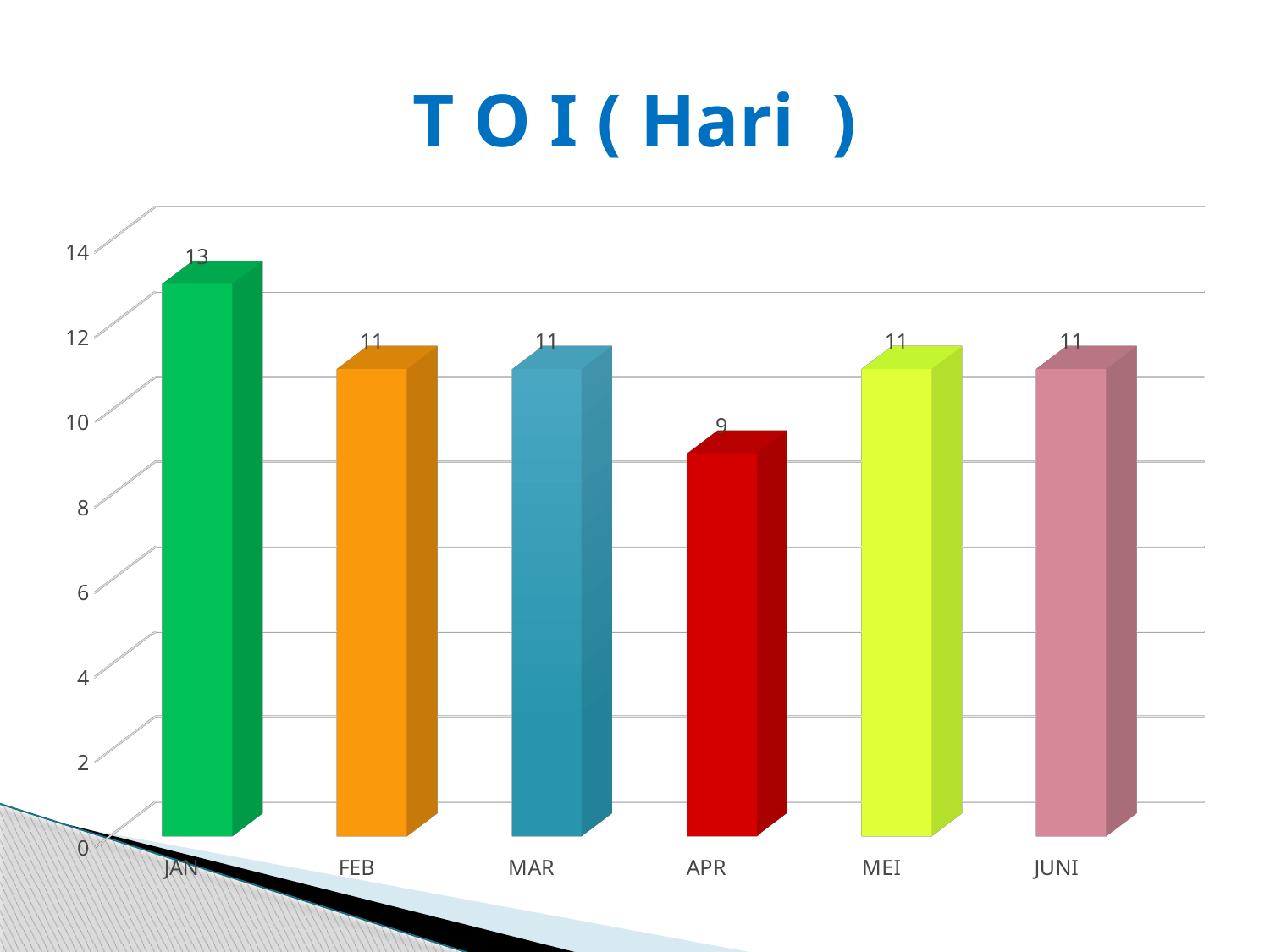
How many months are shown on the x axis? 6 What kind of chart is shown on the slide? bar chart What is the value for MEI? 11 What is the difference between the values for JAN and APR? 4 Which month has the highest value? JAN Is the value for APR greater or less than 10? less Which month has the lowest value? APR What is the title of the chart? T O I ( Hari ) What is the value for JAN? 13 Which is larger, the value for JAN or the value for MAR? JAN What is the value for APR? 9 What is the difference between the values for FEB and APR? 2